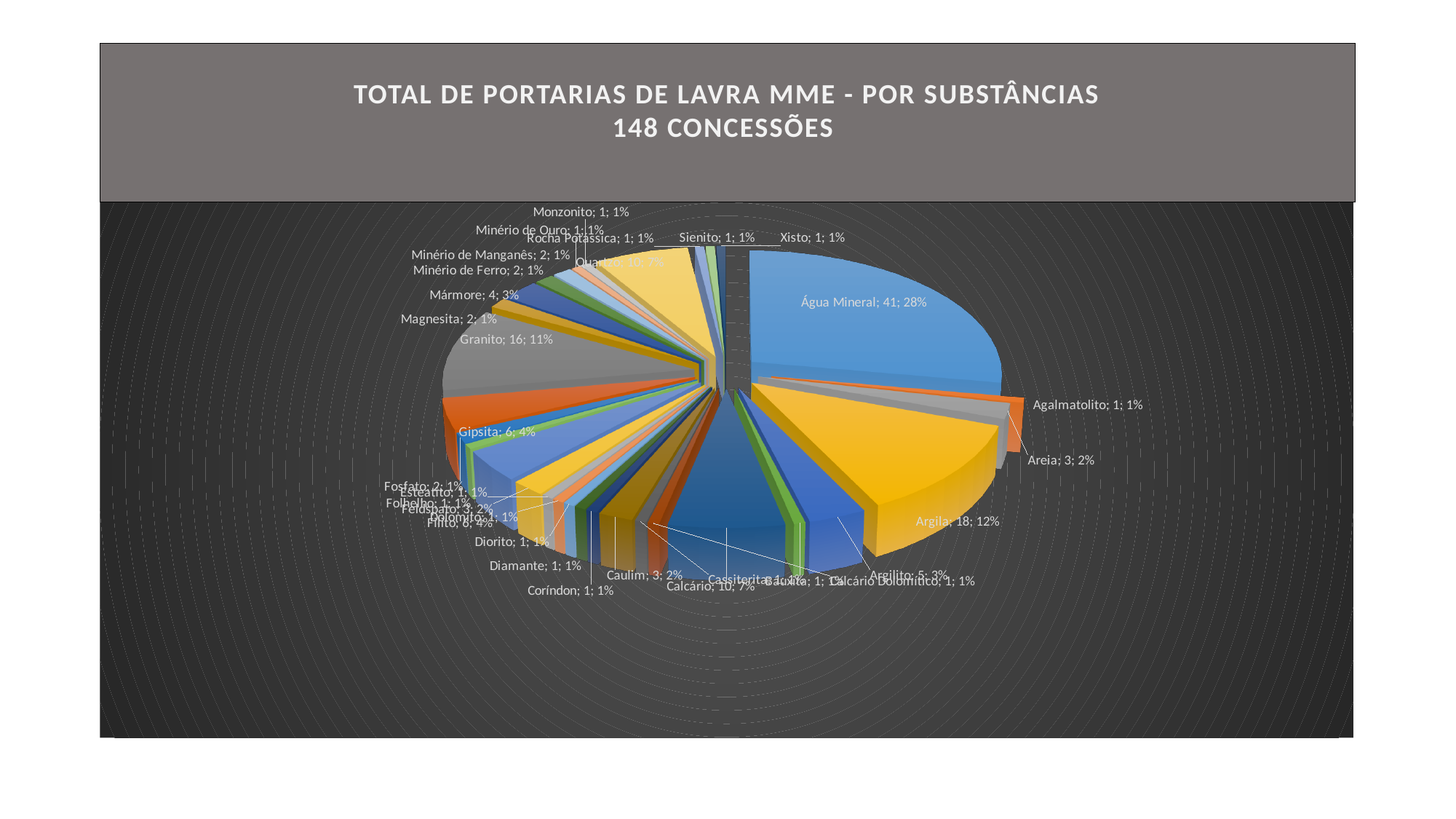
How many concessions are shown for Água Mineral? 41 What is the difference in concessions between Granito and Filito? 10 What share of the pie does Água Mineral represent? 28% What kind of chart is shown on the slide? pie chart What is the title of the chart? TOTAL DE PORTARIAS DE LAVRA MME - POR SUBSTÂNCIAS 148 CONCESSÕES What share of the pie does Gipsita represent? 4% What is the difference in concessions between Água Mineral and Argila? 23 Which substance has the largest slice of the pie? Água Mineral Which has more concessions, Granito or Calcário? Granito How many concessions are shown for Quartzo? 10 How many concessions are shown for Granito? 16 What share of the pie does Argila represent? 12%